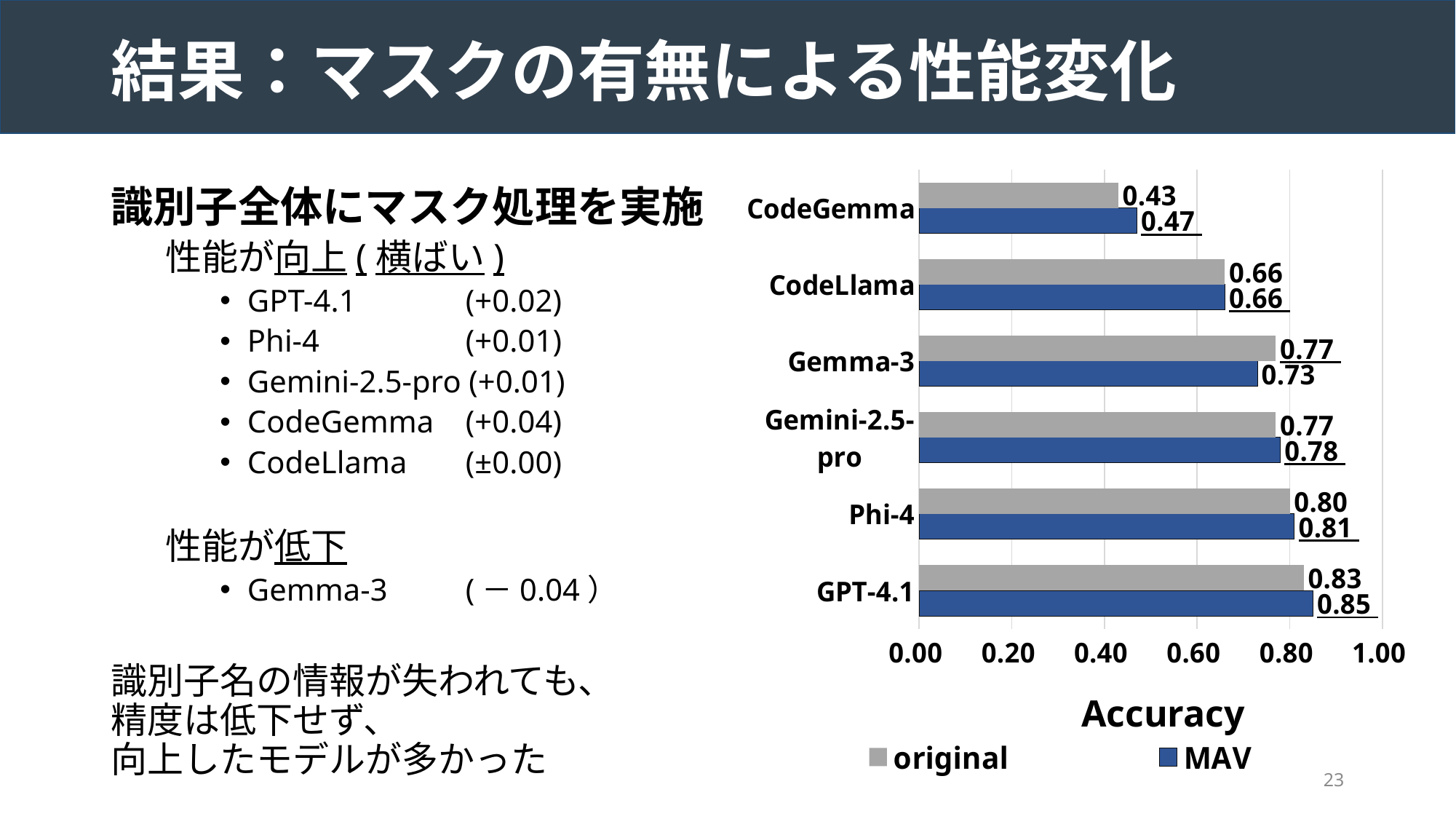
What is the MAV accuracy for CodeGemma? 0.47 Which series is shown in blue in the legend? MAV Which model has the highest MAV accuracy? GPT-4.1 How many models are shown on the chart? 6 What is the original accuracy for Gemma-3? 0.77 Which model has the lowest original accuracy? CodeGemma How many series does the legend list? 2 What is the difference between the MAV and original accuracy for CodeGemma? 0.04 What is the label of the horizontal axis of the chart? Accuracy What kind of chart is shown on the slide? bar chart Which is larger for Gemma-3, the original accuracy or the MAV accuracy? original What is the MAV accuracy for GPT-4.1? 0.85